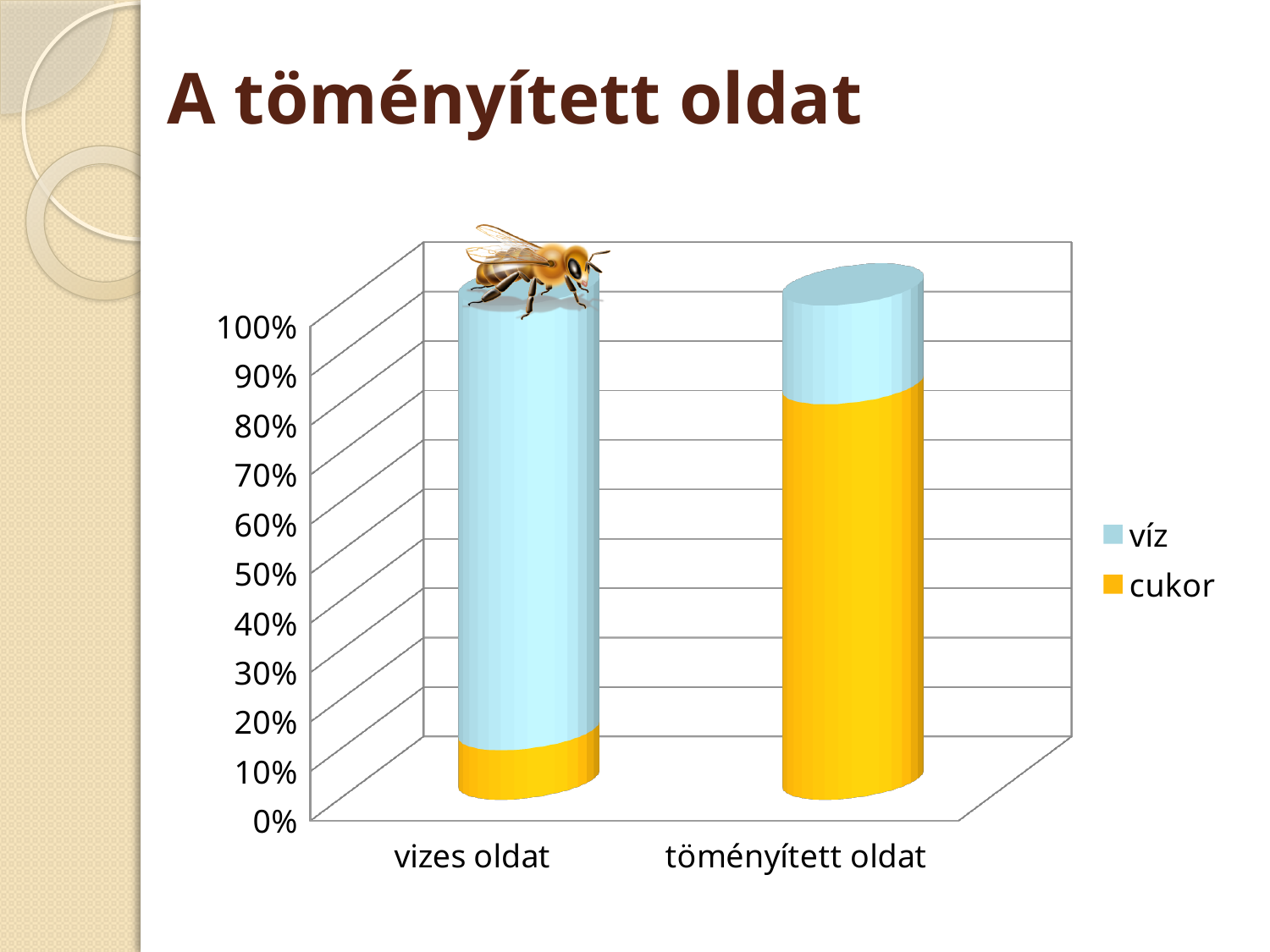
Which category has the larger cukor share, vizes oldat or töményített oldat? töményített oldat Which category has the larger víz share, vizes oldat or töményített oldat? vizes oldat Which category has the lowest cukor value? vizes oldat Is the víz value for töményített oldat greater or less than 50%? less Is the cukor value for töményített oldat greater or less than 50%? greater How many series does the chart legend list? 2 Is the cukor value for vizes oldat greater or less than 20%? less What is the title of the slide containing the chart? A töményített oldat What kind of chart is shown on the slide? stacked bar chart What are the two series listed in the chart legend? víz and cukor How many categories are shown on the x axis of the chart? 2